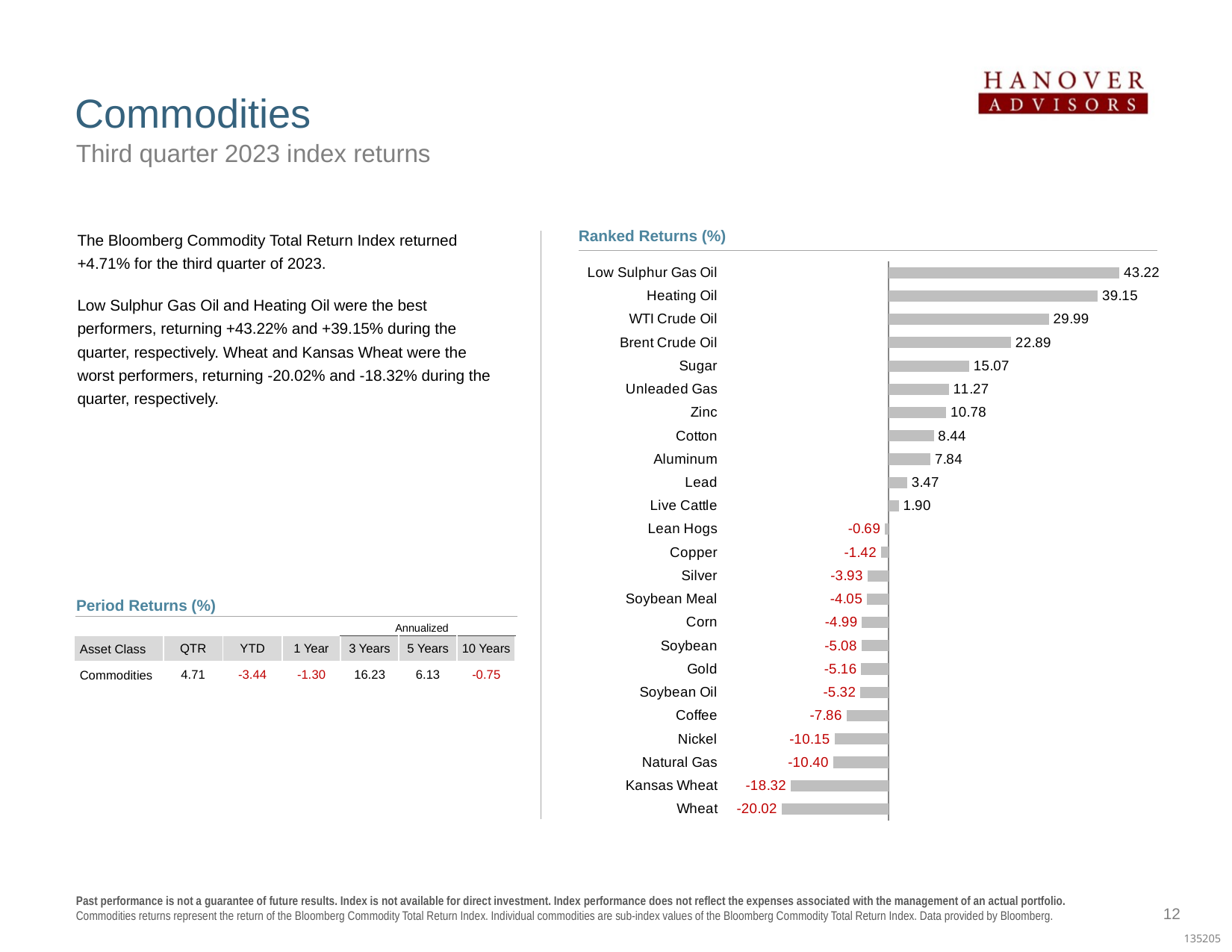
In the Ranked Returns (%) chart, which is larger, the value for Cotton or the value for Aluminum? Cotton Which commodity has the highest value in the Ranked Returns (%) chart? Low Sulphur Gas Oil Which commodity has the lowest value in the Ranked Returns (%) chart? Wheat How many commodities are shown in the Ranked Returns (%) chart? 24 What is the difference between the values for Sugar and Zinc in the Ranked Returns (%) chart? 4.29 What is the title of the chart on the slide? Ranked Returns (%) What kind of chart is the Ranked Returns (%) chart? Bar chart What is the difference between the values for Low Sulphur Gas Oil and Heating Oil in the Ranked Returns (%) chart? 4.07 What is the value for WTI Crude Oil in the Ranked Returns (%) chart? 29.99 What is the value for Copper in the Ranked Returns (%) chart? -1.42 In the Ranked Returns (%) chart, which is larger, the value for Nickel or the value for Coffee? Coffee What is the value for Natural Gas in the Ranked Returns (%) chart? -10.40